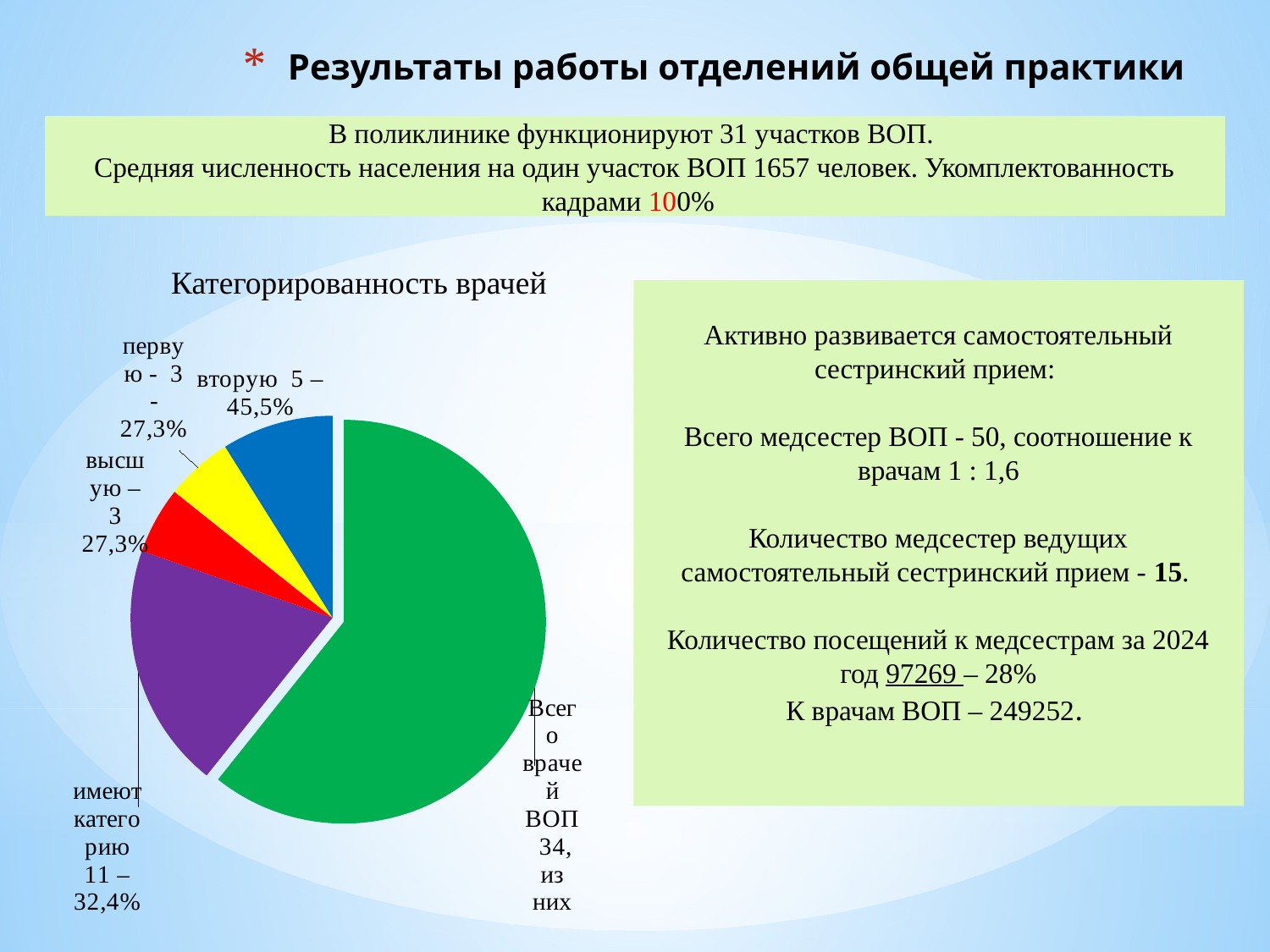
What is the difference between the number for "имеют категорию" (11) and the number for "вторую" (5)? 6 Which is larger: the number for "вторую" or the number for "первую"? вторую What is the difference between the total number of doctors (34) and the number who have a category (11)? 23 What colour is the largest slice of the pie chart? green How many doctors are shown for the slice labelled "имеют категорию"? 11 What kind of chart is shown on the slide? pie chart What percentage is shown for the slice labelled "первую"? 27,3% How many doctors are shown for the slice labelled "высшую"? 3 What percentage is shown for the slice labelled "вторую"? 45,5% Which slice of the pie chart is the largest? Всего врачей ВОП What is the title of the chart on the slide? Категорированность врачей How many slices does the pie chart have? 5